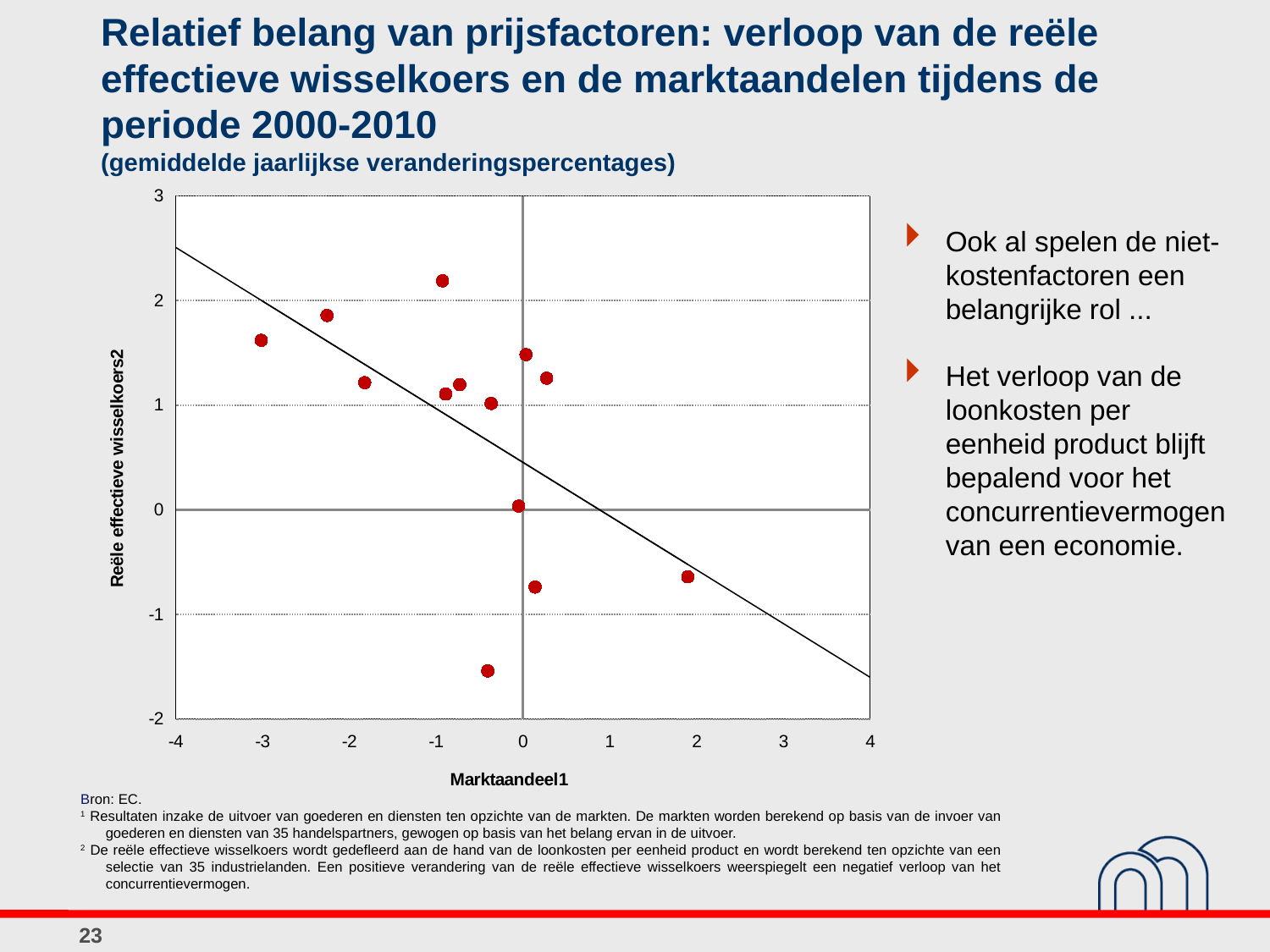
What is the lowest value shown on the vertical axis of the chart? -2 What is the title of the horizontal axis of the chart? Marktaandeel1 How many data points lie below 0 on the vertical axis (negative real effective exchange rate change)? 3 Is the highest plotted point in the chart greater or less than 2 on the vertical axis? greater How many data points lie above 0 on the vertical axis? 10 What kind of chart is shown on the slide? Scatter chart Does the fitted line in the chart rise or fall as the market share (Marktaandeel) increases along the x axis? Fall Is the lowest plotted point in the chart greater or less than -1 on the vertical axis? less Is the relationship between market share and the real effective exchange rate shown by the trend line positive or negative? Negative What is the highest value shown on the horizontal axis of the chart? 4 How many data points are plotted in the scatter chart? 13 What is the title of the vertical axis of the chart? Reële effectieve wisselkoers2